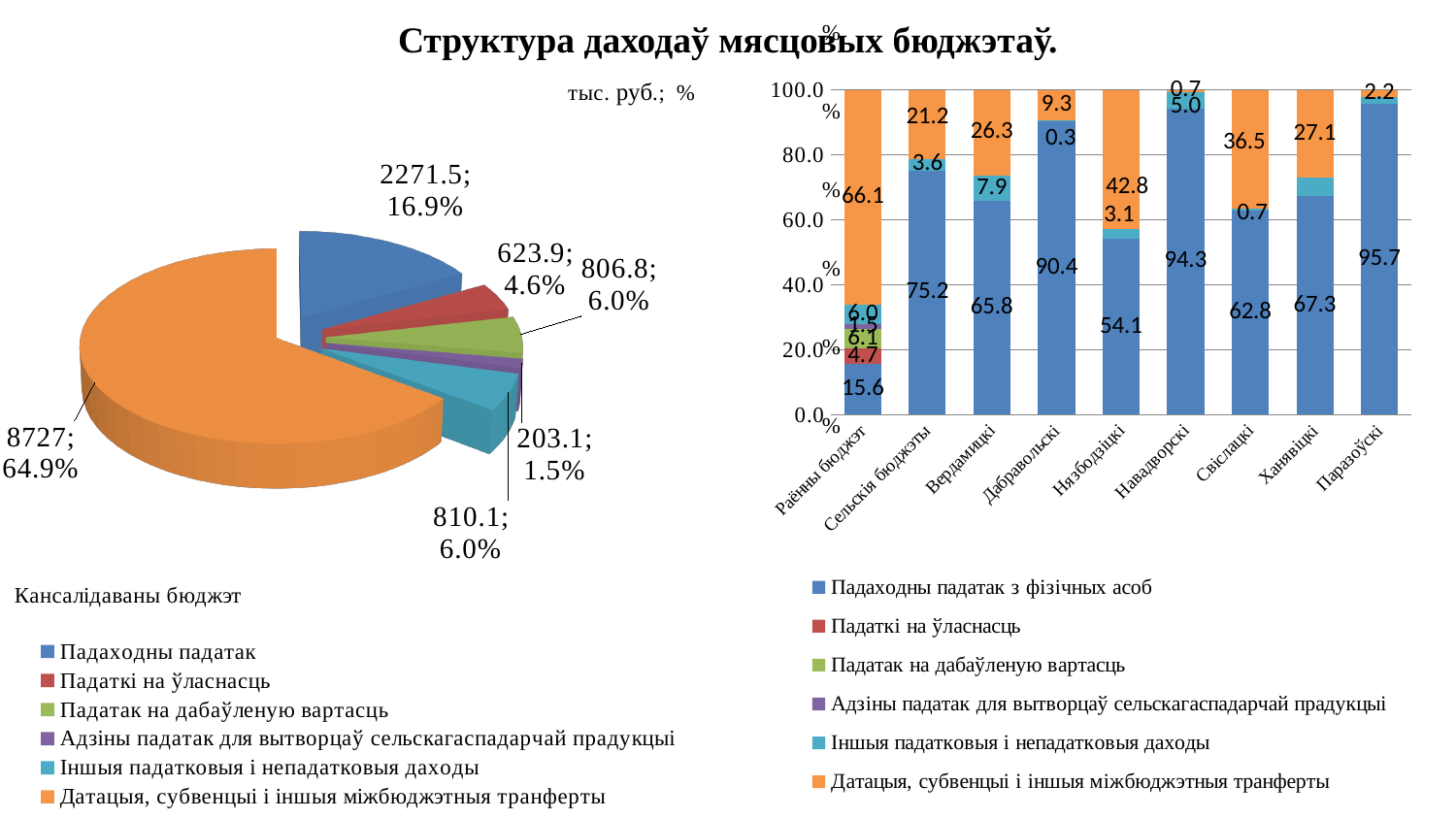
In the stacked bar chart on the right, what is the value of Падаходны падатак з фізічных асоб for Паразоўскі? 95.7 In the pie chart on the left, what is the difference between the values 2271.5 and 623.9? 1647.6 In the stacked bar chart on the right, which category has the lowest value for Падаходны падатак з фізічных асоб? Раённы бюджэт In the pie chart on the left, which category has the smallest slice? Адзіны падатак для вытворцаў сельскагаспадарчай прадукцыі How many categories are shown on the x axis of the stacked bar chart on the right? 9 In the stacked bar chart on the right, what is the value of Датацыя, субвенцыі і іншыя міжбюджэтныя трансферты for Нязбодзіцкі? 42.8 How many series does the legend of the stacked bar chart on the right list? 6 In the pie chart on the left, what share does the slice labelled 8727 represent? 64.9% What type of chart is shown on the right side of the slide? Stacked bar chart In the stacked bar chart on the right, which is larger: the Падаходны падатак з фізічных асоб value for Свіслацкі or for Ханявіцкі? Ханявіцкі In the pie chart on the left, which category has the largest slice? Датацыя, субвенцыі і іншыя міжбюджэтныя транферты In the pie chart on the left, what is the value of the slice for Падаходны падатак (the blue slice)? 2271.5